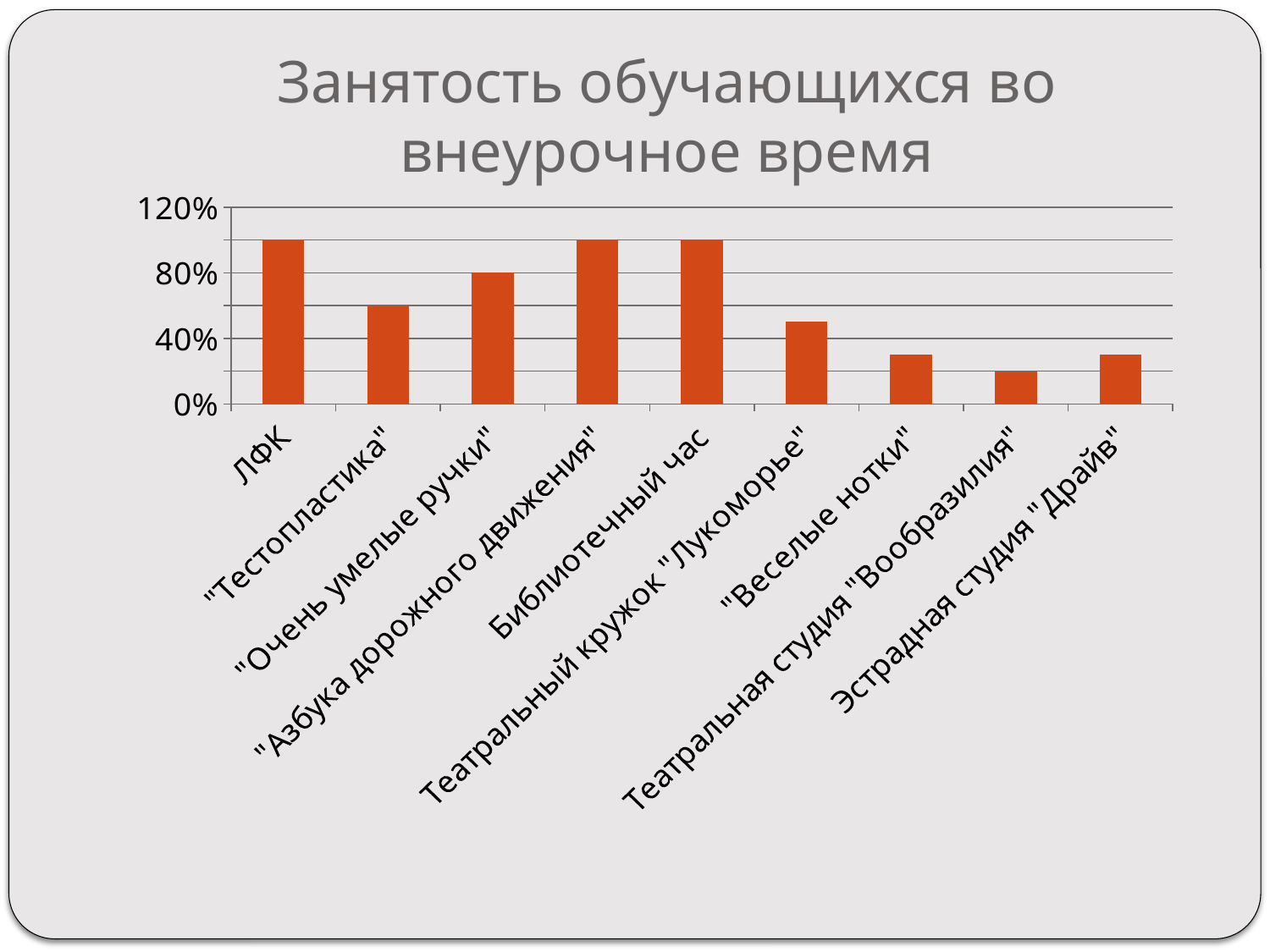
Which is larger, the value for "Азбука дорожного движения" or the value for Эстрадная студия "Драйв"? "Азбука дорожного движения" Is the value for ЛФК greater or less than 80%? greater What is the title of the chart? Занятость обучающихся во внеурочное время How many categories are shown on the x axis of the chart? 9 What is the value for "Очень умелые ручки"? 80% Is the value for "Веселые нотки" greater or less than 40%? less Which is larger, the value for ЛФК or the value for "Тестопластика"? ЛФК Is the value for Библиотечный час greater or less than 80%? greater Which category has the lowest value? Театральная студия "Вообразилия" What kind of chart is shown on the slide? bar chart